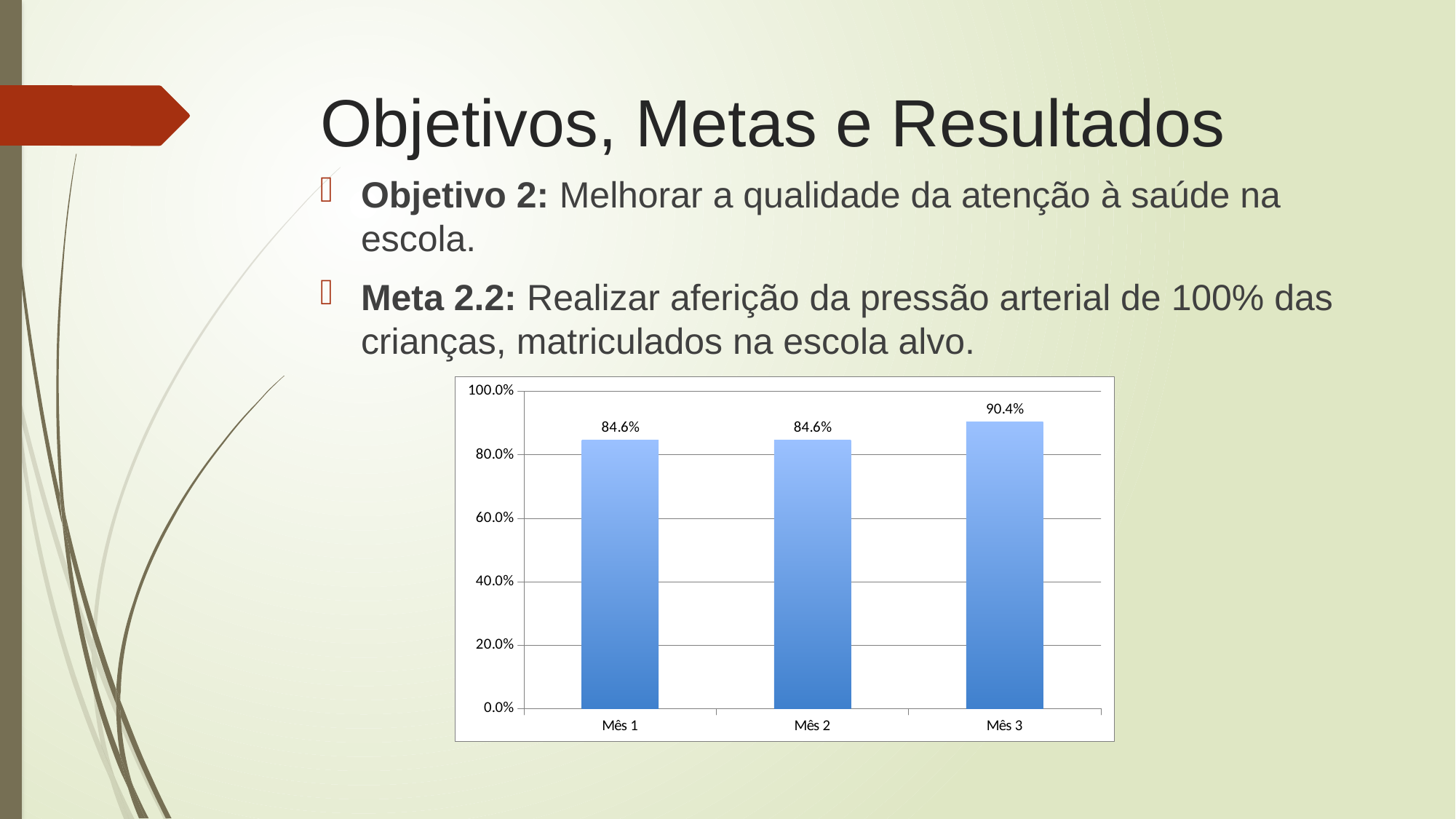
What is the highest tick shown on the y axis? 100.0% Do the values rise or fall from Mês 2 to Mês 3? rise What is the value for Mês 1? 84.6% Is the value for Mês 3 greater or less than 100.0%? less Is the value for Mês 2 greater or less than 80.0%? greater Do Mês 1 and Mês 2 have the same value? Yes Which is larger, the value for Mês 1 or the value for Mês 3? Mês 3 What kind of chart is shown on the slide? bar chart What is the value for Mês 3? 90.4% What is the difference between the values for Mês 3 and Mês 2? 5.8% How many months are shown on the x axis? 3 Which month has the highest value? Mês 3